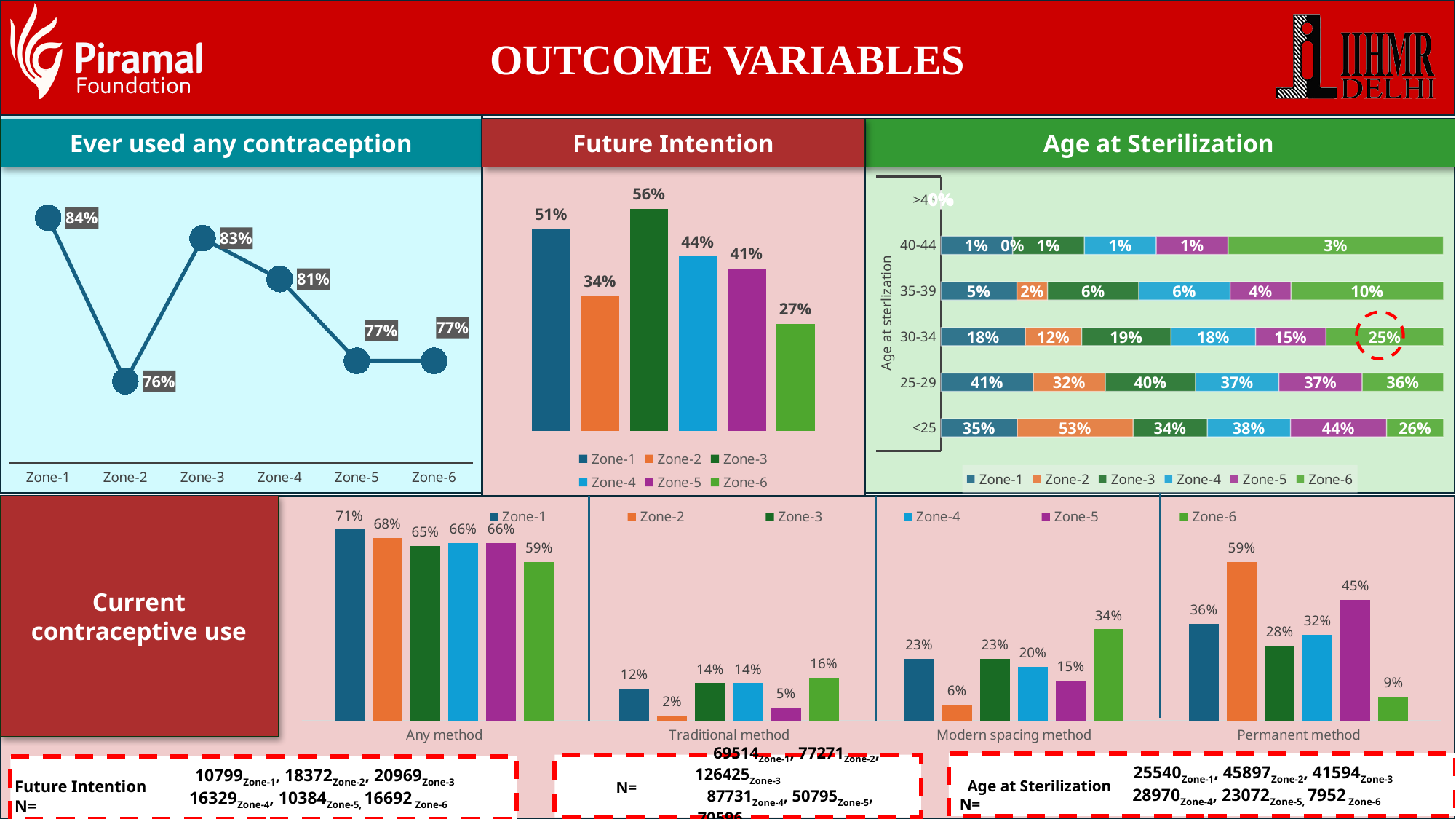
In the 'Age at Sterilization' chart, how many age groups are shown on the vertical axis? 6 In the 'Future Intention' chart, what is the difference between Zone-1 and Zone-2? 17% In the 'Future Intention' chart, what is the value for Zone-3? 56% In the 'Ever used any contraception' chart, what is the value for Zone-2? 76% What kind of chart is the 'Ever used any contraception' chart? Line chart In the 'Future Intention' chart, which zone has the lowest value? Zone-6 In the 'Age at Sterilization' chart, what is the Zone-2 value for the <25 age group? 53% In the 'Current contraceptive use' chart, what is the Zone-2 value for Permanent method? 59% How many series does the legend of the 'Future Intention' chart list? 6 In the 'Current contraceptive use' chart, which is larger for Modern spacing method: Zone-6 or Zone-1? Zone-6 In the 'Ever used any contraception' chart, which zone has the highest value? Zone-1 In the 'Age at Sterilization' chart, what is the Zone-6 value for the 30-34 age group? 25%